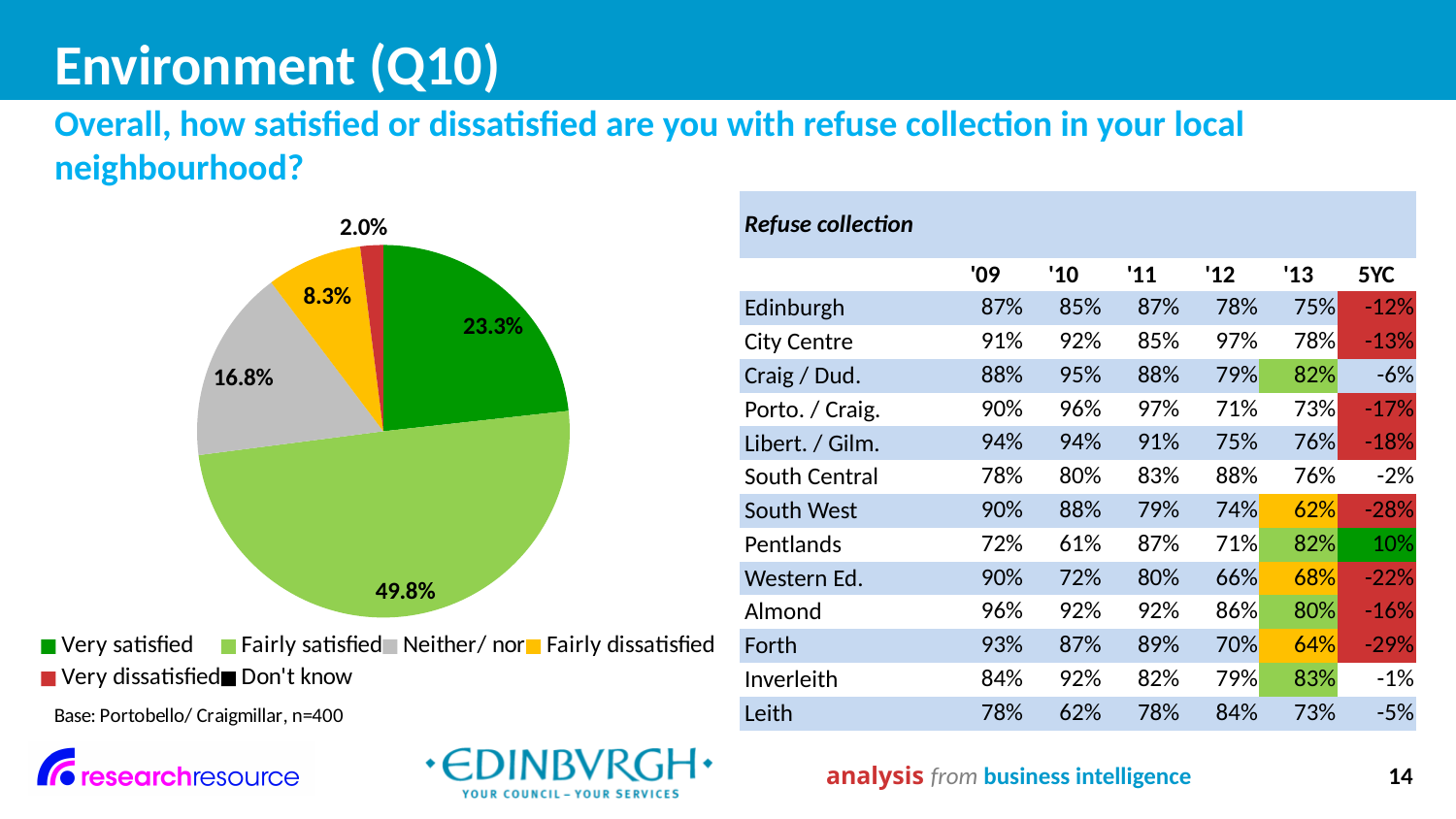
What percentage does the pie chart show for Fairly dissatisfied? 8.3% Which slice is larger in the pie chart, Very satisfied or Neither/ nor? Very satisfied What is the value shown for the Neither/ nor slice of the pie chart? 16.8% What is the value of the Very dissatisfied slice in the pie chart? 2.0% Which category has the largest slice in the pie chart? Fairly satisfied What share of the pie chart is labelled Fairly satisfied? 49.8% What percentage of respondents are very satisfied with refuse collection according to the pie chart? 23.3% What type of chart is used on the left of the slide? Pie chart What is the combined share of the Very satisfied and Fairly satisfied slices in the pie chart? 73.1% By how many percentage points does the Fairly satisfied slice exceed the Very satisfied slice? 26.5 percentage points What base is stated beneath the pie chart? Portobello/ Craigmillar, n=400 How many entries does the pie chart's legend list? 6